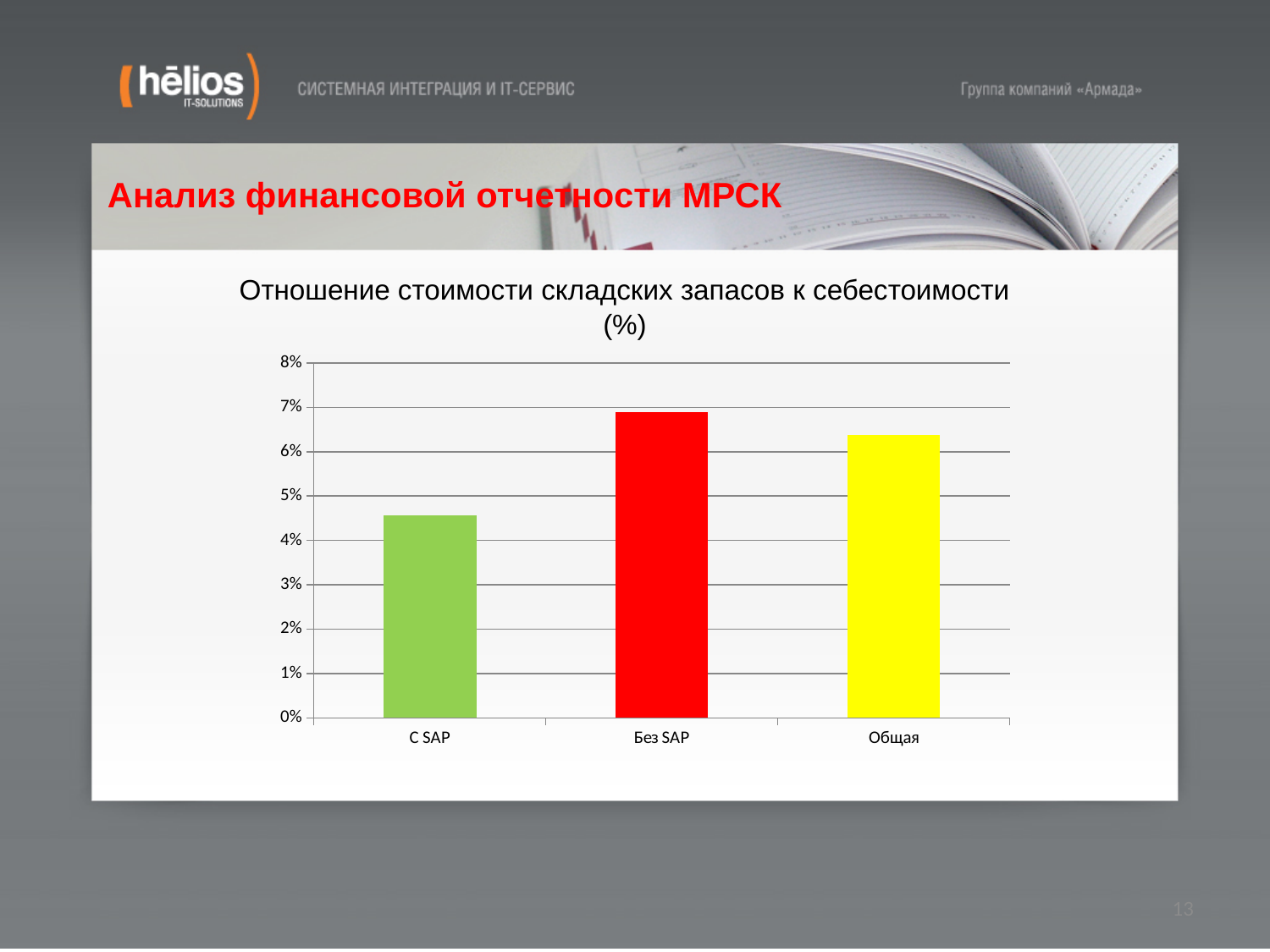
Which category has the lowest value in the chart? С SAP Which category has the highest value in the chart? Без SAP Is the value for С SAP greater or less than 5%? less What colour is the bar for Без SAP? red What is the title of the chart? Отношение стоимости складских запасов к себестоимости (%) Which is larger, the value for С SAP or the value for Без SAP? Без SAP Is the value for С SAP greater or less than 4%? greater Is the value for Без SAP greater or less than 6%? greater How many categories are shown on the x axis of the chart? 3 Which is larger, the value for Общая or the value for Без SAP? Без SAP What kind of chart is shown on the slide? bar chart